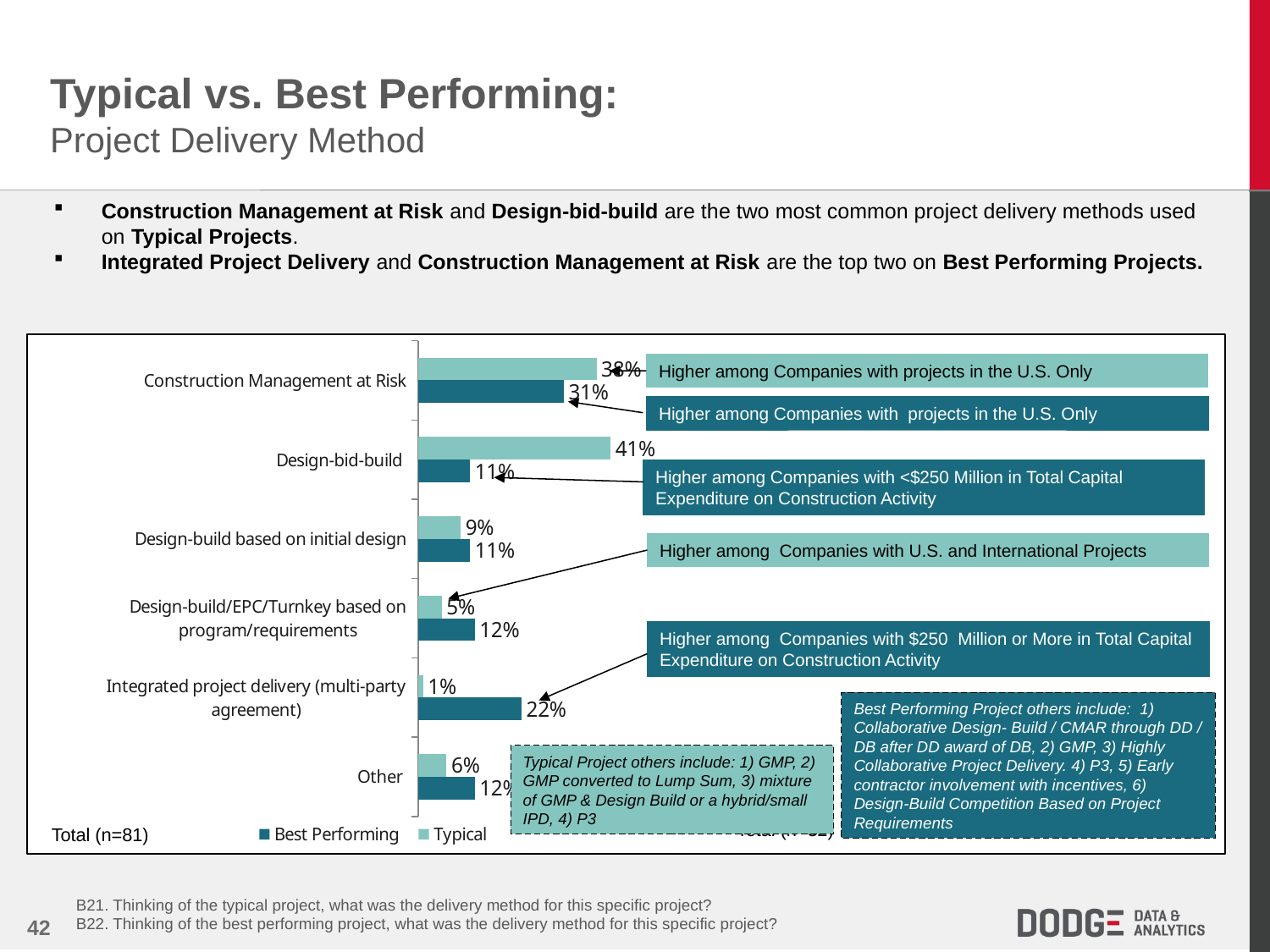
What kind of chart is shown on the slide? Bar chart What is the Best Performing value for Integrated project delivery (multi-party agreement)? 22% What is the Typical value for Design-bid-build? 41% What is the difference between the Typical and Best Performing values for Design-bid-build? 30 percentage points How many project delivery method categories are shown in the chart? 6 For Design-build/EPC/Turnkey based on program/requirements, which is larger: the Best Performing value or the Typical value? Best Performing What is the Best Performing value for Design-bid-build? 11% How many series does the chart legend list? 2 Which delivery method has the highest Best Performing value? Construction Management at Risk Which delivery method has the lowest Typical value? Integrated project delivery (multi-party agreement) Which delivery method has the highest Typical value? Design-bid-build What is the Typical value for Integrated project delivery (multi-party agreement)? 1%